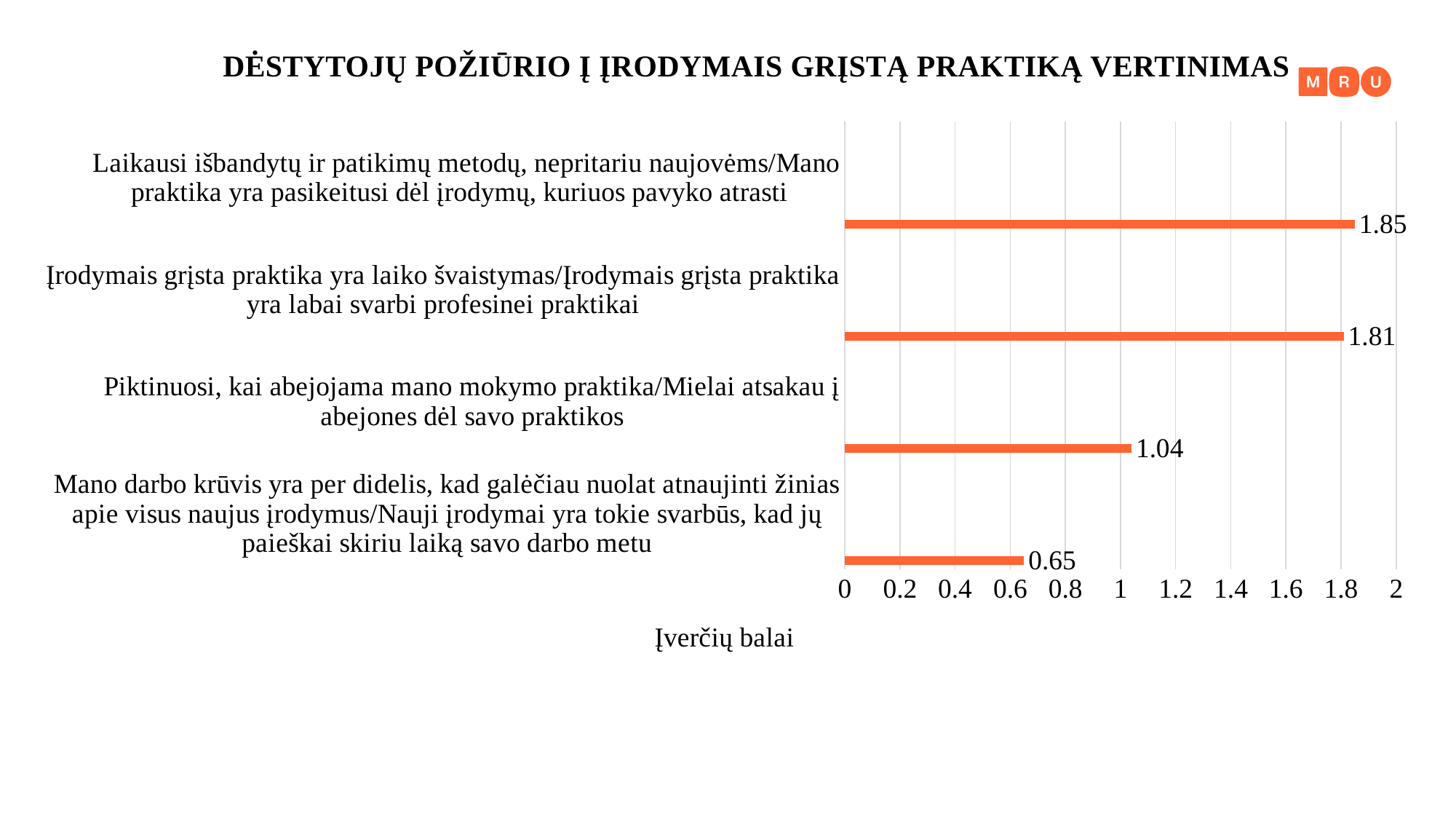
Which is larger: the value for "Piktinuosi, kai abejojama mano mokymo praktika/Mielai atsakau į abejones dėl savo praktikos" or the value for the bottom category "Mano darbo krūvis yra per didelis..."? Piktinuosi, kai abejojama mano mokymo praktika/Mielai atsakau į abejones dėl savo praktikos What is the label of the horizontal axis? Įverčių balai What is the value for the category "Piktinuosi, kai abejojama mano mokymo praktika/Mielai atsakau į abejones dėl savo praktikos"? 1.04 What is the difference between the top two bars, 1.85 and 1.81? 0.04 How many categories (bars) does the chart show? 4 What is the value for the category "Įrodymais grįsta praktika yra laiko švaistymas/Įrodymais grįsta praktika yra labai svarbi profesinei praktikai"? 1.81 What is the value for the category "Laikausi išbandytų ir patikimų metodų, nepritariu naujovėms/Mano praktika yra pasikeitusi dėl įrodymų, kuriuos pavyko atrasti"? 1.85 What is the value for the category "Mano darbo krūvis yra per didelis, kad galėčiau nuolat atnaujinti žinias apie visus naujus įrodymus/Nauji įrodymai yra tokie svarbūs, kad jų paieškai skiriu laiką savo darbo metu"? 0.65 What is the difference between the value for "Piktinuosi, kai abejojama mano mokymo praktika/Mielai atsakau į abejones dėl savo praktikos" and the value for "Mano darbo krūvis yra per didelis..." (the bottom category)? 0.39 Which category has the lowest value? Mano darbo krūvis yra per didelis, kad galėčiau nuolat atnaujinti žinias apie visus naujus įrodymus/Nauji įrodymai yra tokie svarbūs, kad jų paieškai skiriu laiką savo darbo metu What kind of chart is shown on the slide? bar chart Which category has the highest value? Laikausi išbandytų ir patikimų metodų, nepritariu naujovėms/Mano praktika yra pasikeitusi dėl įrodymų, kuriuos pavyko atrasti